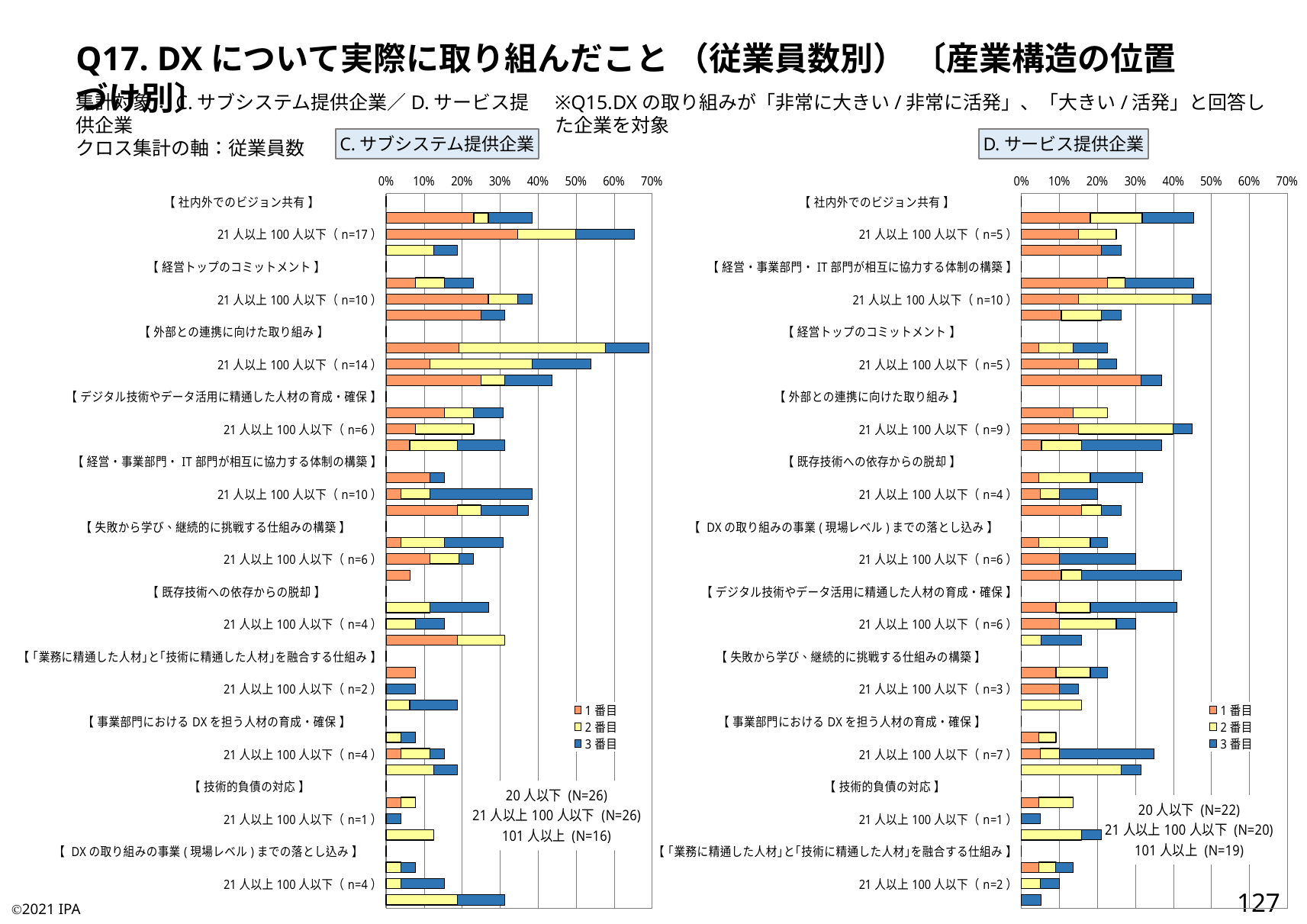
In the D. サービス提供企業 chart, what is the N for 101人以上 shown in the text box? N=19 In the D. サービス提供企業 chart, is the total bar for 21人以上100人以下 (n=10) under 【経営・事業部門・IT部門が相互に協力する体制の構築】 greater or less than 40%? greater How many series does the legend list in the D. サービス提供企業 chart? 3 In the C. サブシステム提供企業 chart, is the total bar for 21人以上100人以下 (n=17) under 【社内外でのビジョン共有】 greater or less than 60%? greater How many category groups (items in 【 】) are listed in the C. サブシステム提供企業 chart? 11 What is the maximum value shown on the horizontal axis of the D. サービス提供企業 chart? 70% In the D. サービス提供企業 chart, which is longer: the bar for 21人以上100人以下 (n=5) under 【経営トップのコミットメント】 or the bar directly below it (101人以上)? The bar directly below it (101人以上) In the C. サブシステム提供企業 chart, is the total bar for 21人以上100人以下 (n=1) under 【技術的負債の対応】 greater or less than 10%? less In the C. サブシステム提供企業 chart, which is longer: the first bar under 【外部との連携に向けた取り組み】 or the first bar under 【既存技術への依存からの脱却】? The first bar under 【外部との連携に向けた取り組み】 What are the legend entries in the C. サブシステム提供企業 chart? 1番目, 2番目, 3番目 What kind of chart is shown under the heading C. サブシステム提供企業? Stacked horizontal bar chart